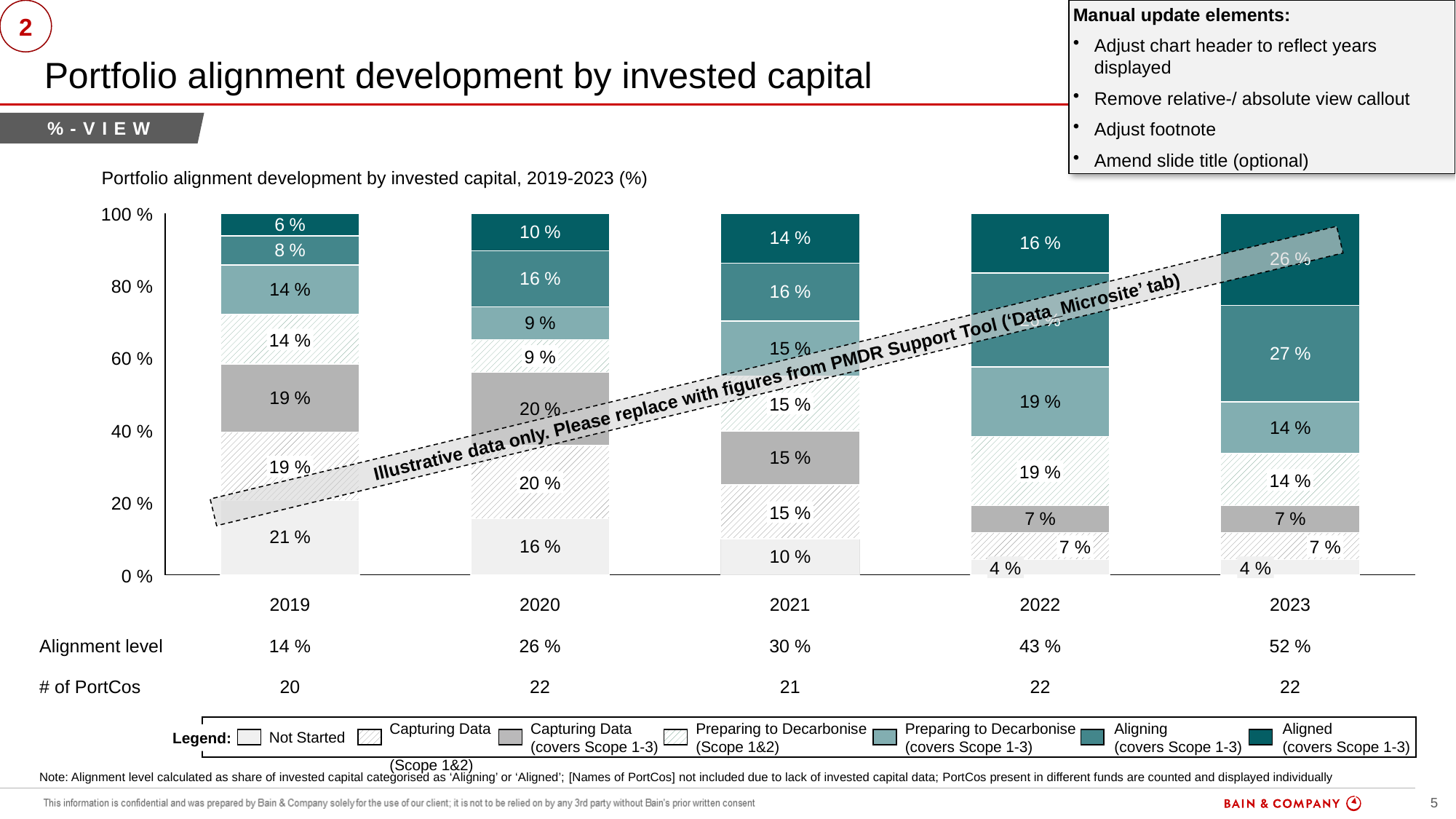
How many series does the legend list? 7 What is the value of the Aligning (covers Scope 1-3) segment for 2020? 16 % Which is larger in 2021: the Aligning (covers Scope 1-3) segment or the Aligned (covers Scope 1-3) segment? Aligning (covers Scope 1-3) What kind of chart is shown on the slide? Stacked bar chart Which year has the highest Aligned (covers Scope 1-3) share? 2023 What is the value of the Aligned (covers Scope 1-3) segment for 2023? 26 % What is the value of the Not Started segment for 2019? 21 % What is the Alignment level shown for 2022? 43 % How many years are shown along the x axis of the chart? 5 By how many percentage points is the Aligned (covers Scope 1-3) segment in 2023 larger than in 2019? 20 % Does the Aligned (covers Scope 1-3) share rise or fall from 2019 to 2023? Rises Which year has the highest Not Started share? 2019